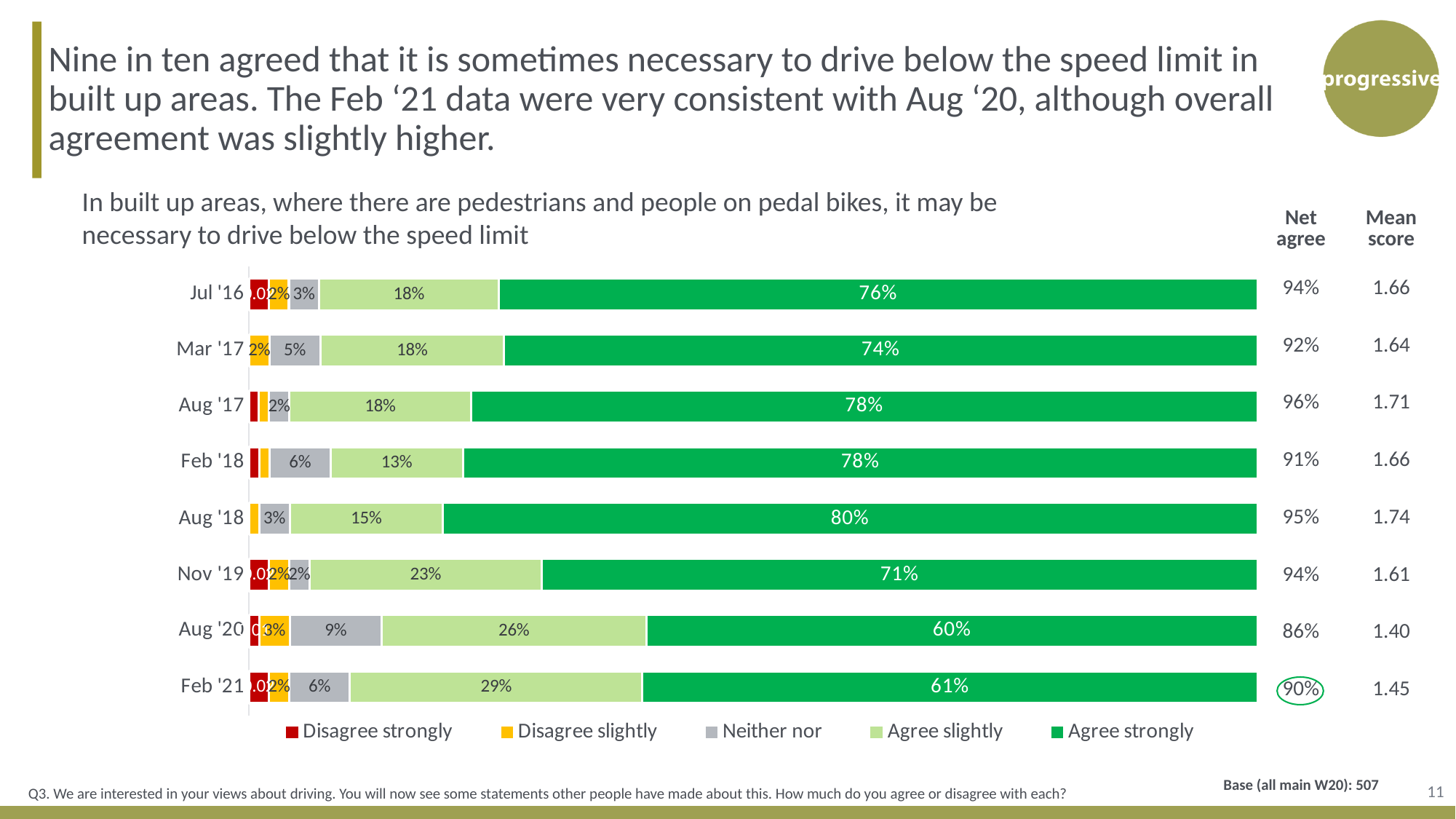
Which series is shown in dark green in the legend? Agree strongly What is the 'Neither nor' value for Aug '20? 9% Which is larger: the 'Agree slightly' value for Nov '19 or for Feb '18? Nov '19 What is the 'Agree slightly' value for Feb '21? 29% Does the 'Agree strongly' value rise or fall from Aug '18 to Aug '20? Fall How many survey waves (categories) are plotted on the chart? 8 How many series does the legend list? 5 Which survey wave has the highest 'Agree strongly' value? Aug '18 What is the 'Agree strongly' value for Aug '18? 80% What type of chart is shown on the slide? Stacked bar chart What is the difference between the 'Agree strongly' values for Jul '16 and Feb '21? 15% Which survey wave has the lowest 'Agree strongly' value? Aug '20